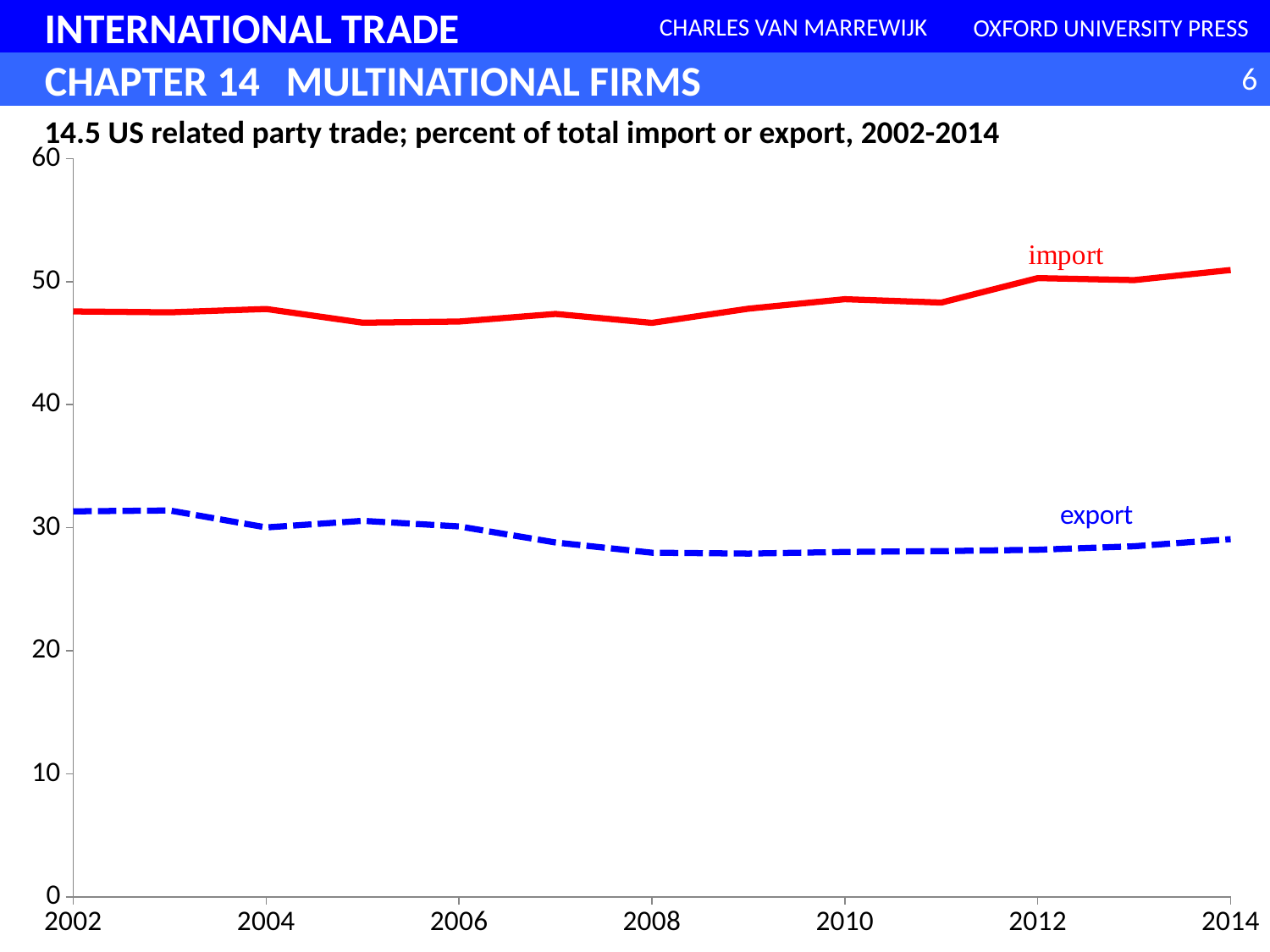
Which series has the higher values throughout the period, import or export? import Which series is drawn with a dashed line? export How many series are plotted on the chart? 2 Is the value for import in 2008 greater or less than 40? greater Is the value for import in 2014 greater or less than 50? greater Is the value for import in 2002 greater or less than 50? less What is the title of the chart? 14.5 US related party trade; percent of total import or export, 2002-2014 Does the export series rise or fall between 2002 and 2008? fall Does the import series rise or fall between 2008 and 2014? rise What kind of chart is shown on the slide? line chart